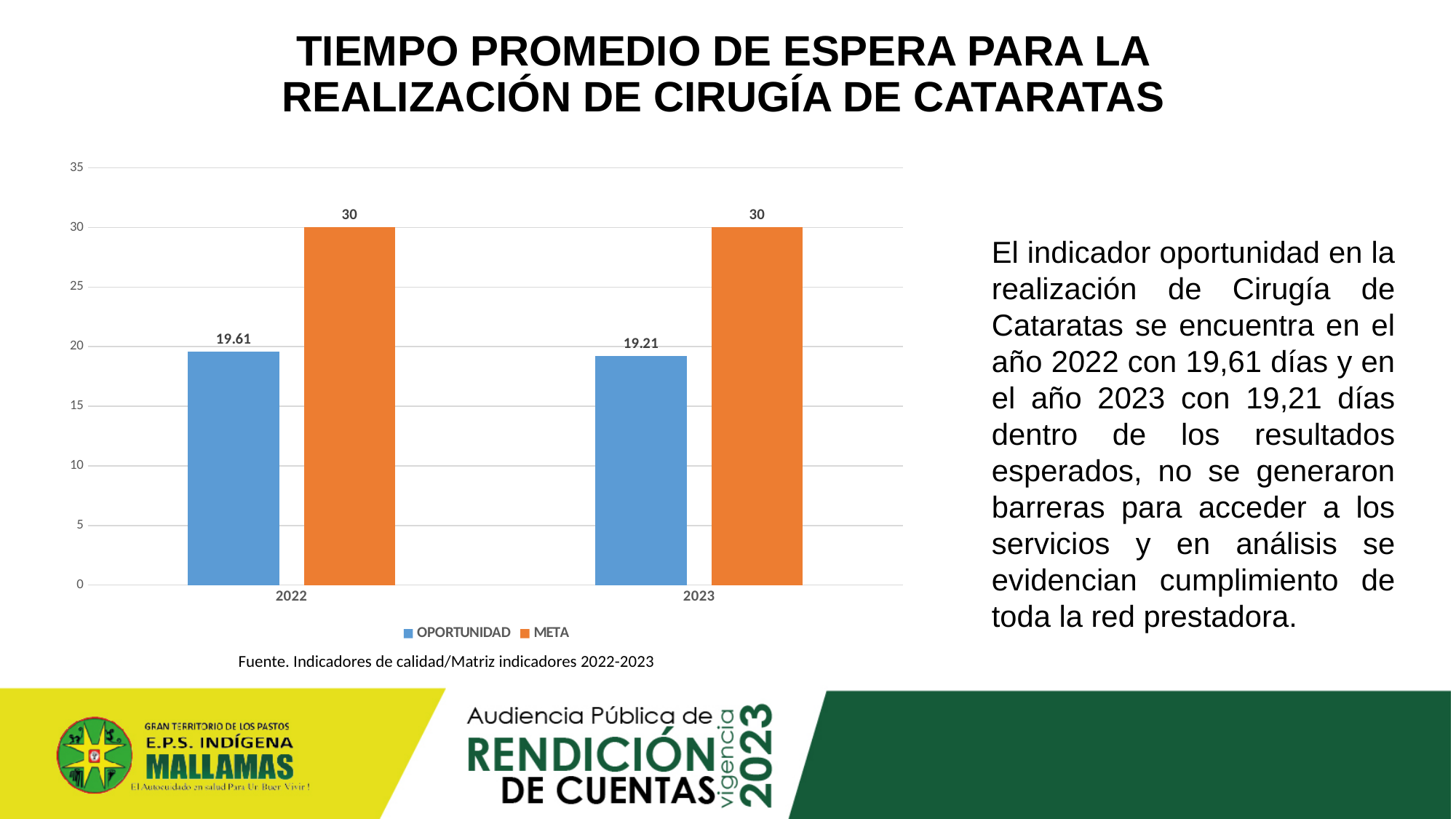
What is the OPORTUNIDAD value for 2023? 19.21 Which year has the higher OPORTUNIDAD value, 2022 or 2023? 2022 What is the META value for 2023? 30 What is the OPORTUNIDAD value for 2022? 19.61 How many series does the legend list? 2 What is the difference between the META and OPORTUNIDAD values for 2022? 10.39 What kind of chart is shown on the slide? bar chart How many years are shown on the x axis of the chart? 2 Does the OPORTUNIDAD value rise or fall from 2022 to 2023? fall Is the OPORTUNIDAD value for 2023 greater or less than 20? less What is the difference between the OPORTUNIDAD values for 2022 and 2023? 0.4 Which colour represents the META series in the chart? orange